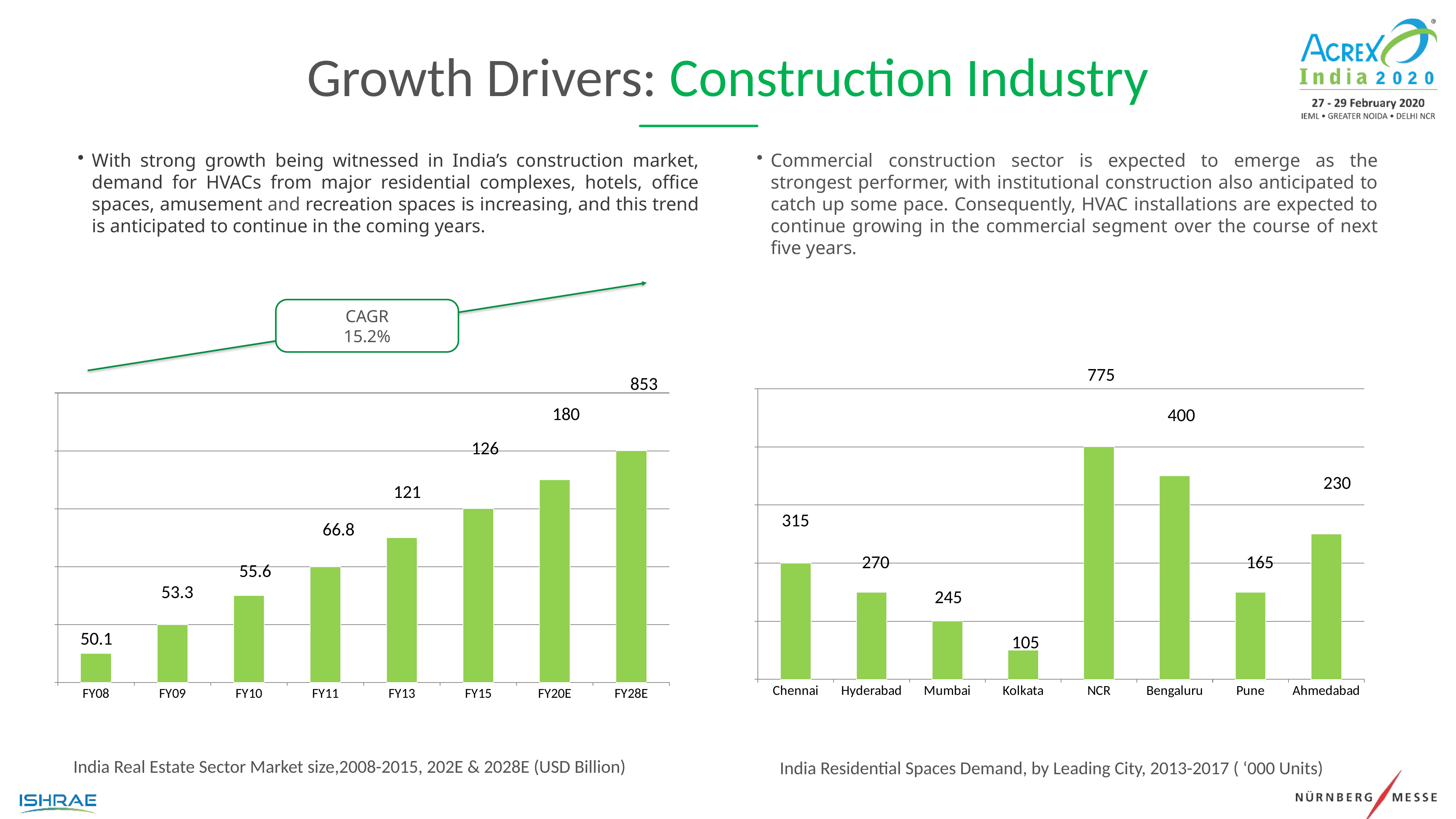
In the right chart (India Residential Spaces Demand), which city has the lowest demand? Kolkata In the left chart (India Real Estate Sector Market size), which fiscal year has the lowest value? FY08 In the right chart (India Residential Spaces Demand), what is the difference between NCR and Bengaluru? 375 In the right chart (India Residential Spaces Demand), which city has the highest demand? NCR In the right chart (India Residential Spaces Demand), what is the value for Hyderabad? 270 In the left chart (India Real Estate Sector Market size), do the values rise or fall from FY08 to FY28E? rise In the left chart (India Real Estate Sector Market size), how many fiscal years are plotted? 8 In the left chart (India Real Estate Sector Market size), what is the difference between the FY20E and FY15 values? 54 In the left chart (India Real Estate Sector Market size), what is the value for FY28E? 853 What CAGR is shown in the callout above the left chart? 15.2% In the left chart (India Real Estate Sector Market size), what is the value for FY11? 66.8 In the right chart (India Residential Spaces Demand), which is larger, Chennai or Ahmedabad? Chennai